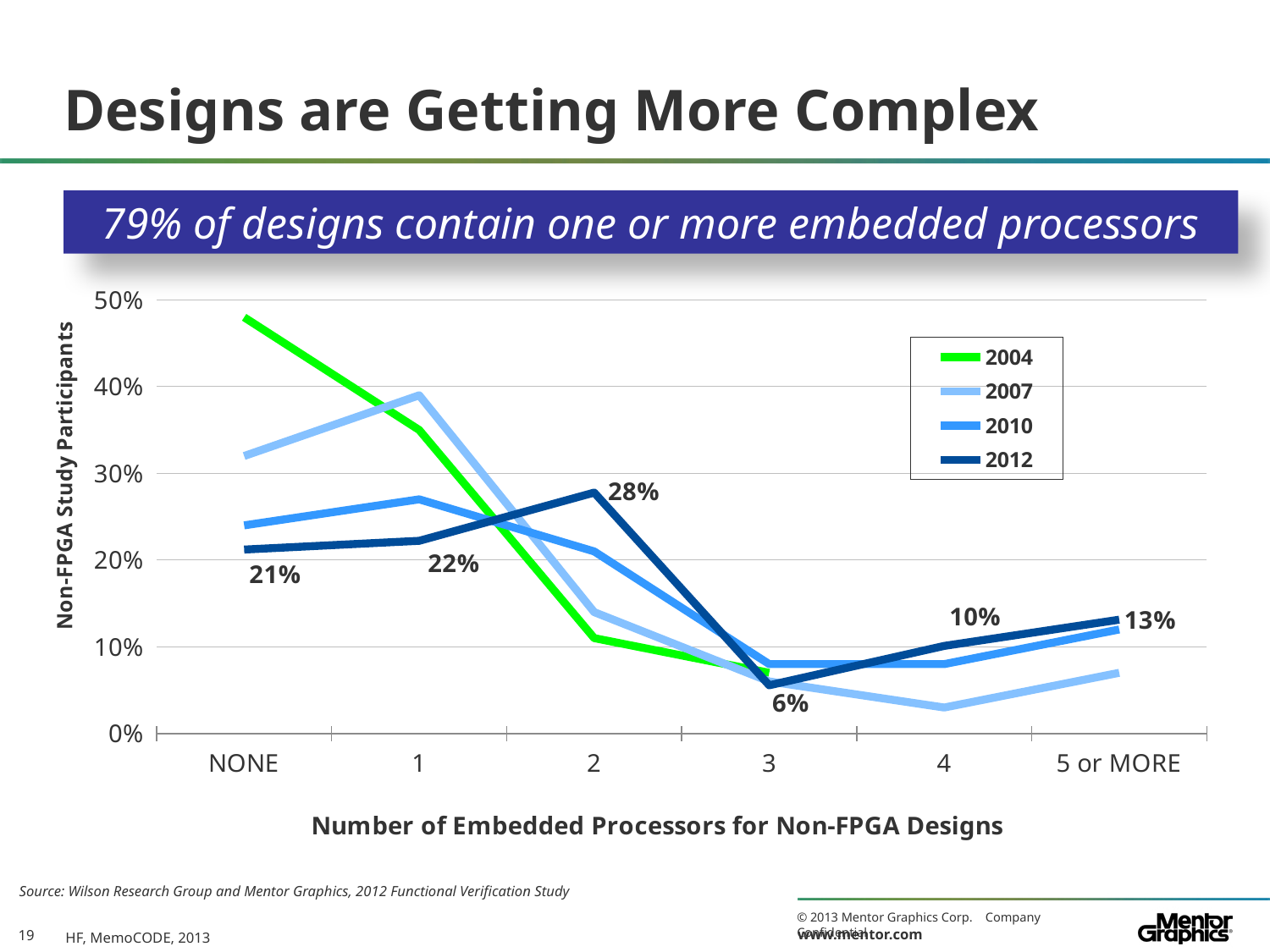
What kind of chart is shown on the slide? line chart How many series does the legend list? 4 What is the value for the 2012 series at 5 or MORE embedded processors? 13% Is the value for the 2004 series at 2 embedded processors greater or less than 20%? less What is the value for the 2012 series at 2 embedded processors? 28% For the 2012 series, which is larger: the value at NONE or the value at 1? 1 For the 2012 series, which number of embedded processors has the lowest value? 3 What is the difference between the 2012 values at 2 and at 3 embedded processors? 22 percentage points How many categories are shown on the x axis? 6 For the 2012 series, which number of embedded processors has the highest value? 2 Is the value for the 2004 series at NONE greater or less than 40%? greater What is the value for the 2012 series at NONE? 21%